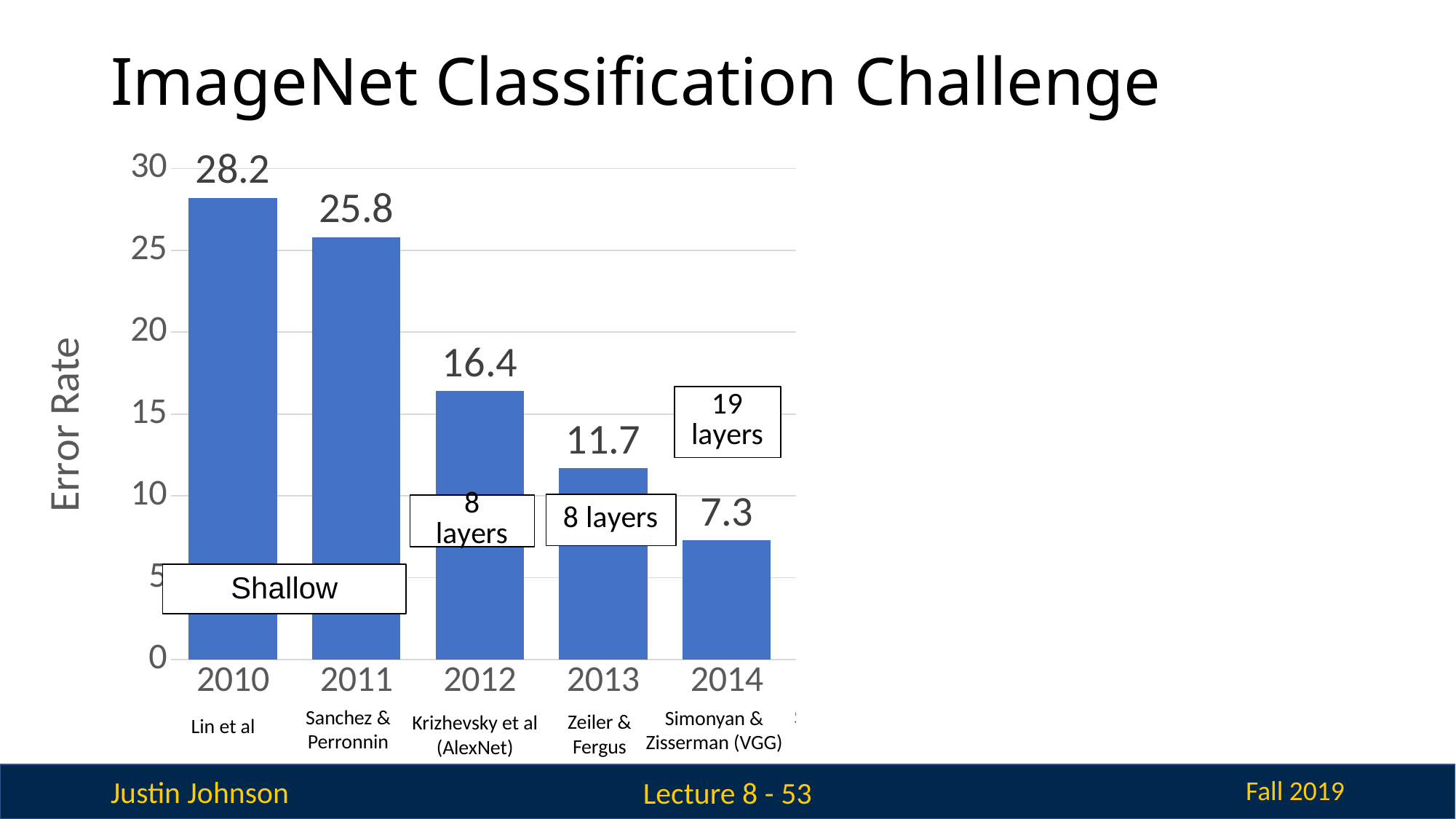
What is the error rate for 2014? 7.3 Which year has the highest error rate? 2010 What is the error rate for 2012? 16.4 Which year has the lowest error rate? 2014 What is the label on the y axis? Error Rate What kind of chart is this? bar chart Does the error rate rise or fall from 2010 to 2014? fall What is the difference in error rate between 2013 and 2014? 4.4 What is the error rate for 2010? 28.2 Which has a higher error rate, 2011 or 2013? 2011 What is the difference in error rate between 2011 and 2012? 9.4 How many years are shown on the x axis? 5